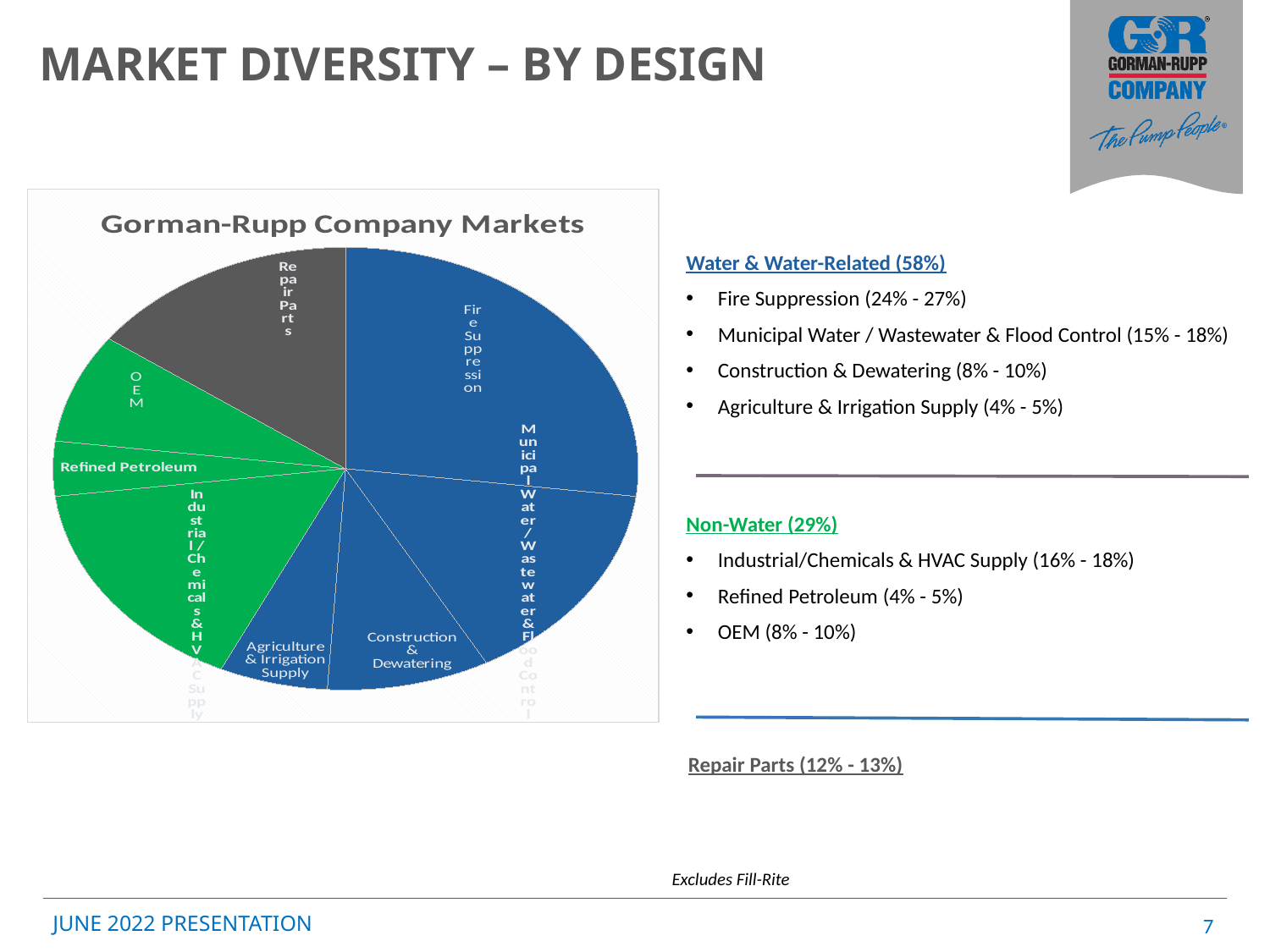
What colour is the Repair Parts slice in the pie chart? Grey Which slice is larger, Industrial/Chemicals & HVAC Supply or Refined Petroleum? Industrial/Chemicals & HVAC Supply What is the title of the chart? Gorman-Rupp Company Markets Which market has the largest slice in the pie chart? Fire Suppression How many slices does the pie chart have? 8 Which slice is larger, Municipal Water / Wastewater & Flood Control or Agriculture & Irrigation Supply? Municipal Water / Wastewater & Flood Control Which slice is larger, Fire Suppression or Repair Parts? Fire Suppression What kind of chart is shown on the slide? Pie chart